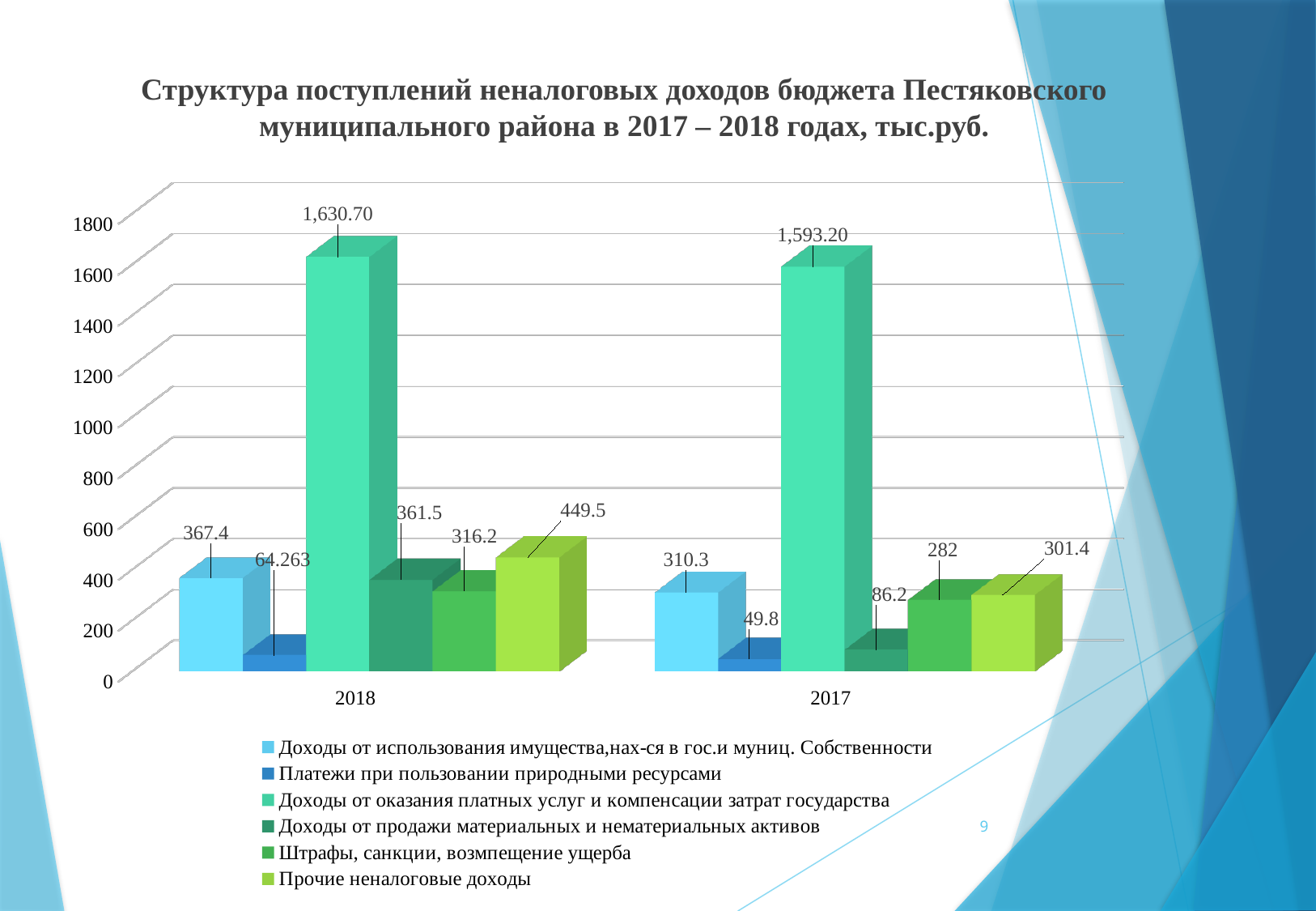
What is the value for "Прочие неналоговые доходы" in 2018? 449.5 How many series does the legend list? 6 Which series has the lowest value in 2018? Платежи при пользовании природными ресурсами What is the value for "Доходы от оказания платных услуг и компенсации затрат государства" in 2018? 1,630.70 Is the value for "Доходы от оказания платных услуг и компенсации затрат государства" in 2017 greater or less than 1400? greater What is the value for "Платежи при пользовании природными ресурсами" in 2017? 49.8 What is the difference between the 2018 and 2017 values for "Доходы от использования имущества,нах-ся в гос.и муниц. Собственности"? 57.1 What kind of chart is shown on the slide? bar chart What is the value for "Штрафы, санкции, возмпещение ущерба" in 2017? 282 Which series has the highest value in 2017? Доходы от оказания платных услуг и компенсации затрат государства Which is larger: the value for "Доходы от продажи материальных и нематериальных активов" in 2018 or in 2017? 2018 How many year categories are shown on the x axis? 2